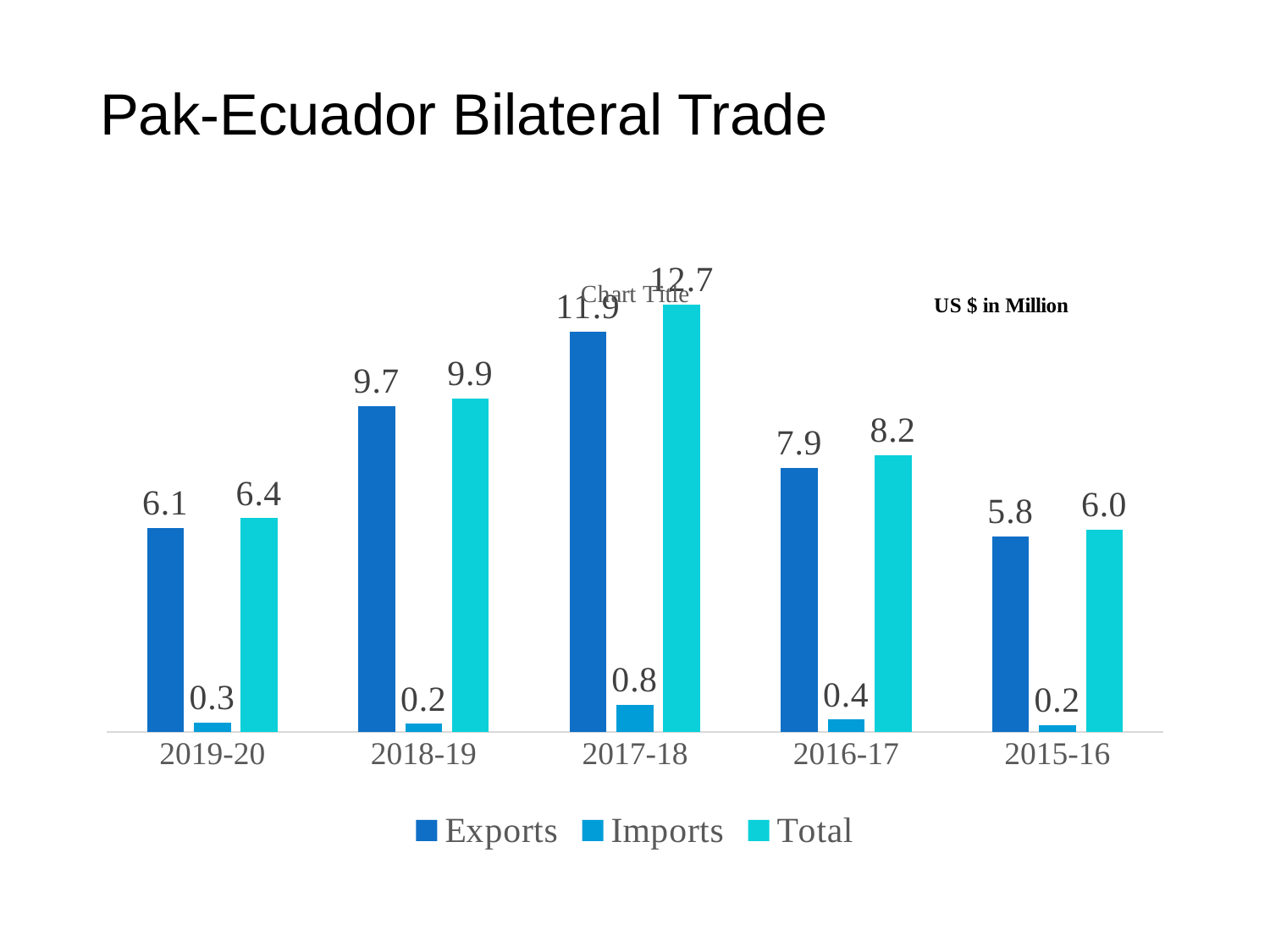
Which is larger, Exports in 2018-19 or Exports in 2016-17? Exports in 2018-19 Which year has the lowest Exports value? 2015-16 What kind of chart is shown on the slide? Bar chart What is the difference between the Total and Exports values for 2019-20? 0.3 What is the value of Imports for 2016-17? 0.4 What unit is stated for the values in the chart? US $ in Million What is the difference between Imports in 2017-18 and Imports in 2015-16? 0.6 What is the Total value for 2018-19? 9.9 How many series does the legend list? 3 How many years are shown on the x axis? 5 Which year has the highest Total value? 2017-18 What is the value of Exports for 2017-18? 11.9